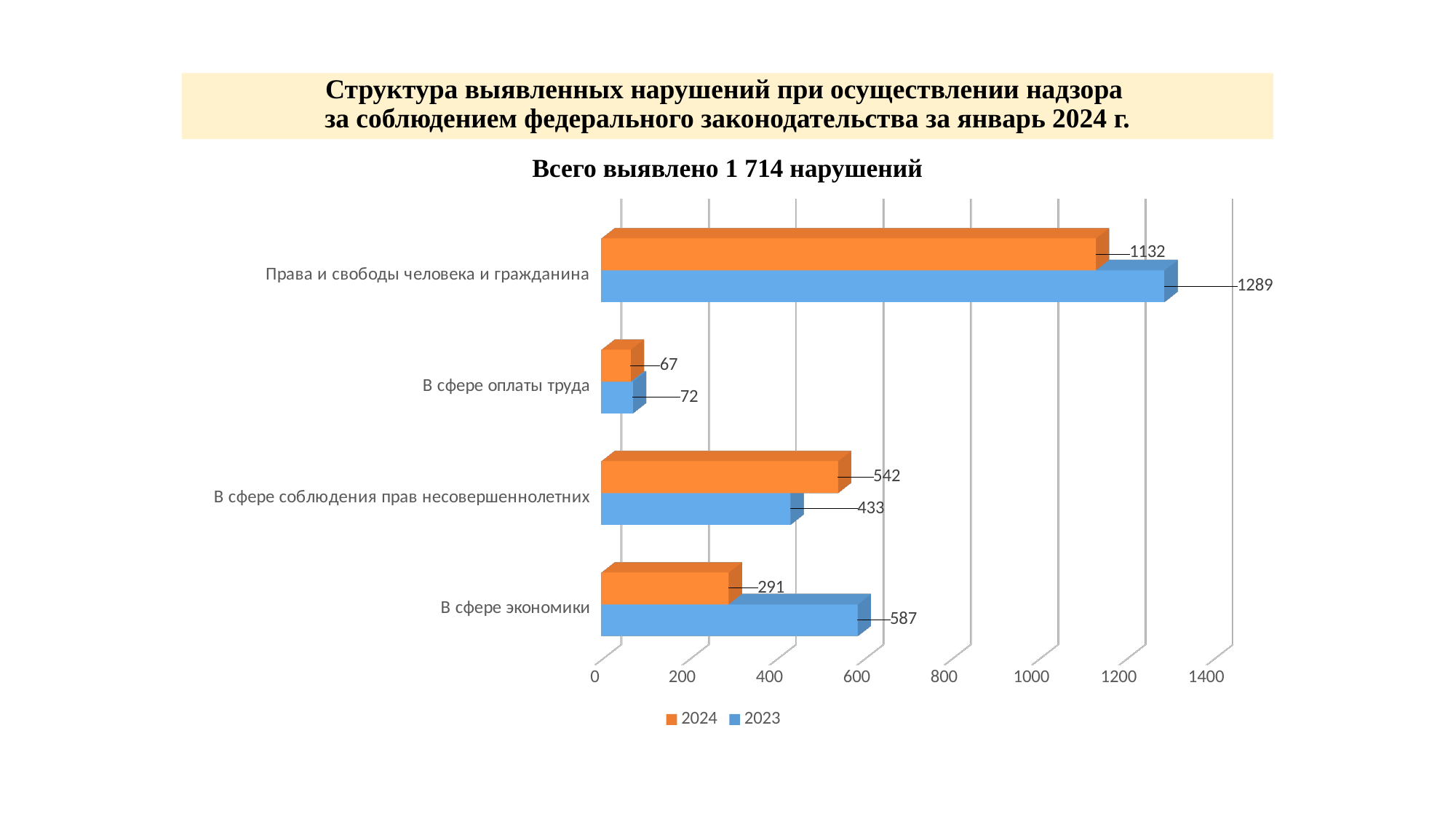
How many categories are shown on the chart? 4 What is the difference between the 2023 and 2024 values for "В сфере экономики"? 296 What is the 2023 value for "В сфере экономики"? 587 What kind of chart is shown on the slide? Bar chart Which colour represents the 2023 series? Blue Which category has the highest 2023 value? Права и свободы человека и гражданина What is the 2024 value for "Права и свободы человека и гражданина"? 1132 Which category has the lowest 2024 value? В сфере оплаты труда How many series does the legend list? 2 What is the difference between the 2023 and 2024 values for "Права и свободы человека и гражданина"? 157 What is the 2024 value for "В сфере оплаты труда"? 67 For "В сфере соблюдения прав несовершеннолетних", which year has the larger value, 2024 or 2023? 2024